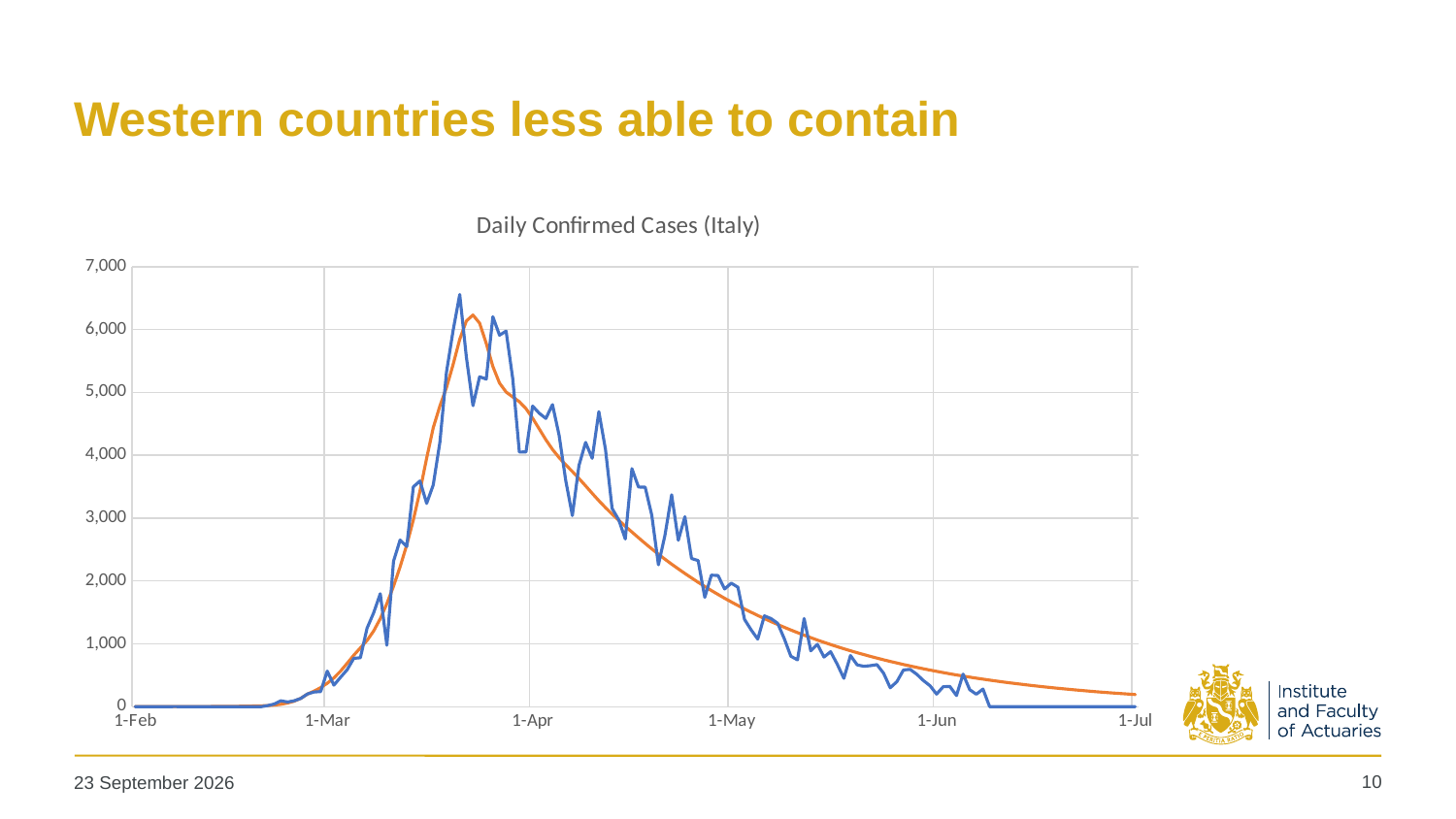
Is the peak value of the orange line greater or less than 5,000? greater What is the title of the chart? Daily Confirmed Cases (Italy) Do the values rise or fall between 1-Apr and 1-Jul? fall Is the value of the orange line on 1-Jun greater or less than 1,000? less Is the value of the blue line on 1-Mar greater or less than 1,000? less Which line reaches a higher peak, the blue line or the orange line? blue line What kind of chart is shown on the slide? line chart How many date labels are shown on the x axis? 6 How many lines are plotted on the chart? 2 Between which two x-axis dates does the peak of daily confirmed cases occur? 1-Mar and 1-Apr